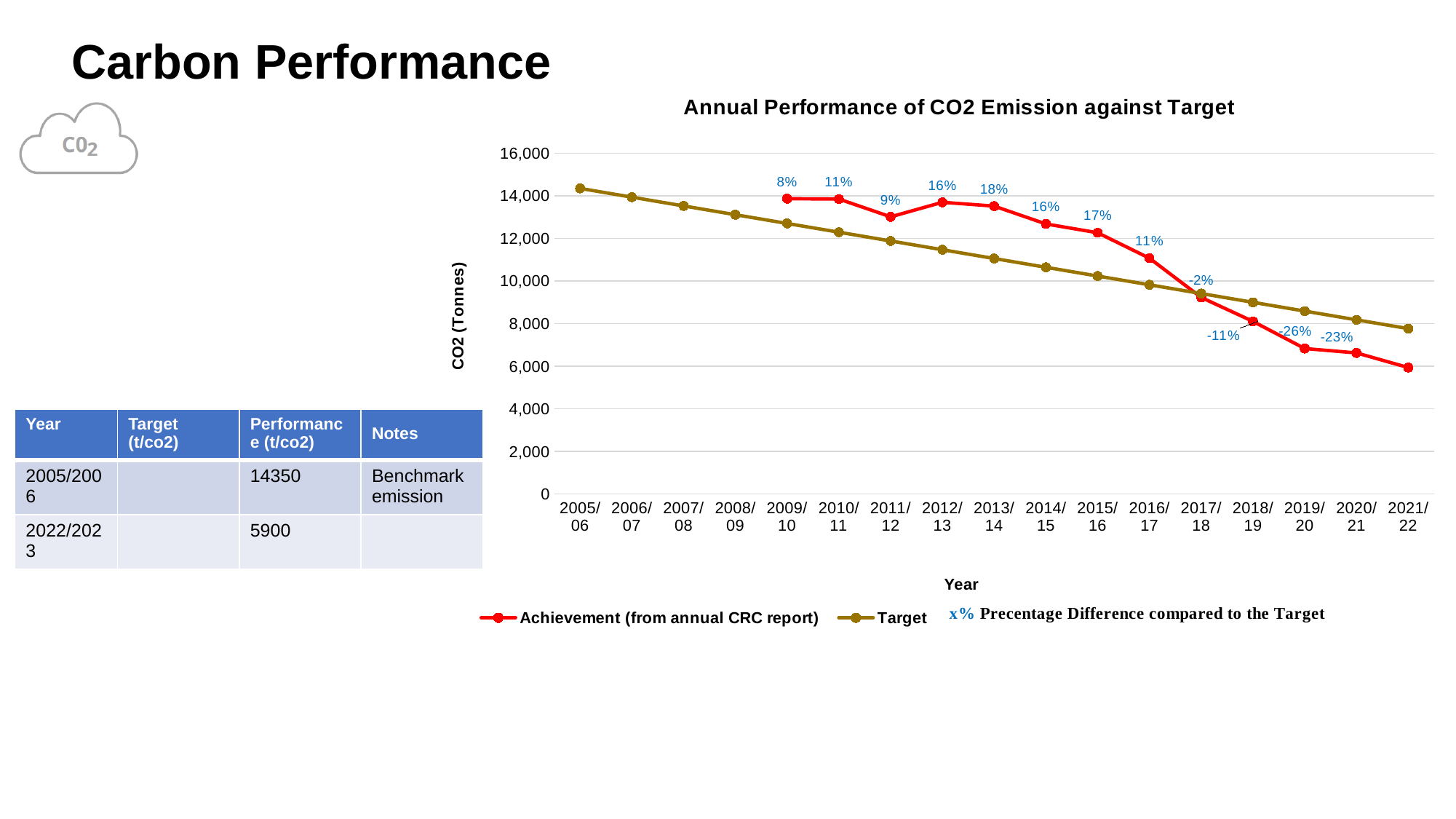
Which year has the lowest percentage difference label on the chart? 2019/20 Is the Target value for 2005/06 greater or less than 14,000? greater What percentage difference label is shown for 2019/20? -26% How many years are shown along the x axis of the chart? 17 Which year has the highest percentage difference label on the chart? 2013/14 In 2019/20, which series has the higher value, Achievement or Target? Target How many series does the chart legend list? 2 In 2013/14, which series has the higher value, Achievement or Target? Achievement What type of chart is shown on the slide? line chart What percentage difference label is shown for 2013/14? 18% What percentage difference label is shown for 2009/10? 8% What is the title of the chart? Annual Performance of CO2 Emission against Target